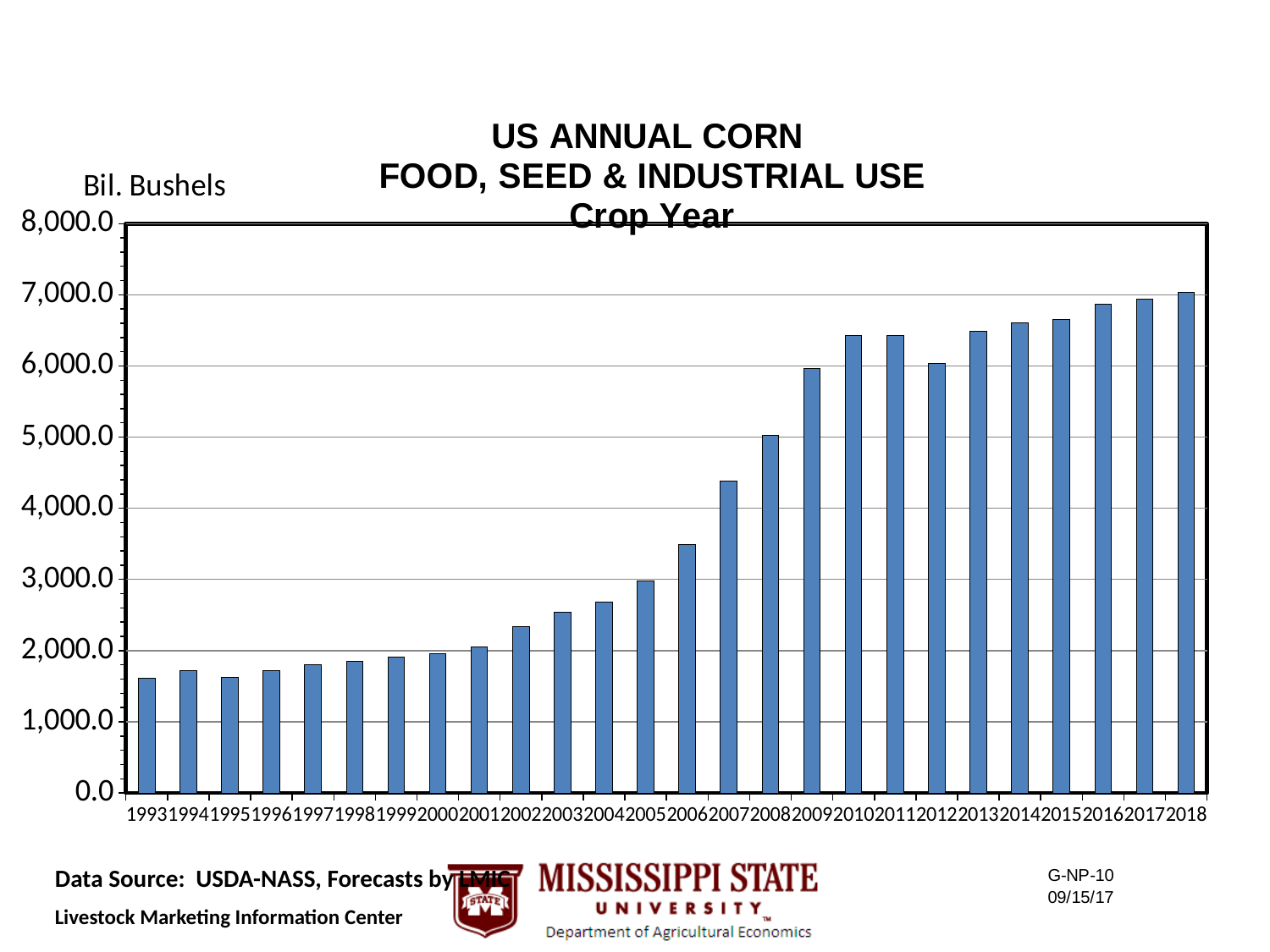
What unit is shown on the vertical axis label? Bil. Bushels How many crop years are plotted on the chart? 26 Is the value for 2016 greater or less than 7,000.0? less Do the values generally rise or fall from 1993 to 2018? rise Is the value for 2007 greater or less than 4,000.0? greater What kind of chart is shown on the slide? bar chart Is the value for 1999 greater or less than 2,000.0? less Which crop year has the highest corn food, seed & industrial use? 2018 Which crop year has the larger value, 2011 or 2012? 2011